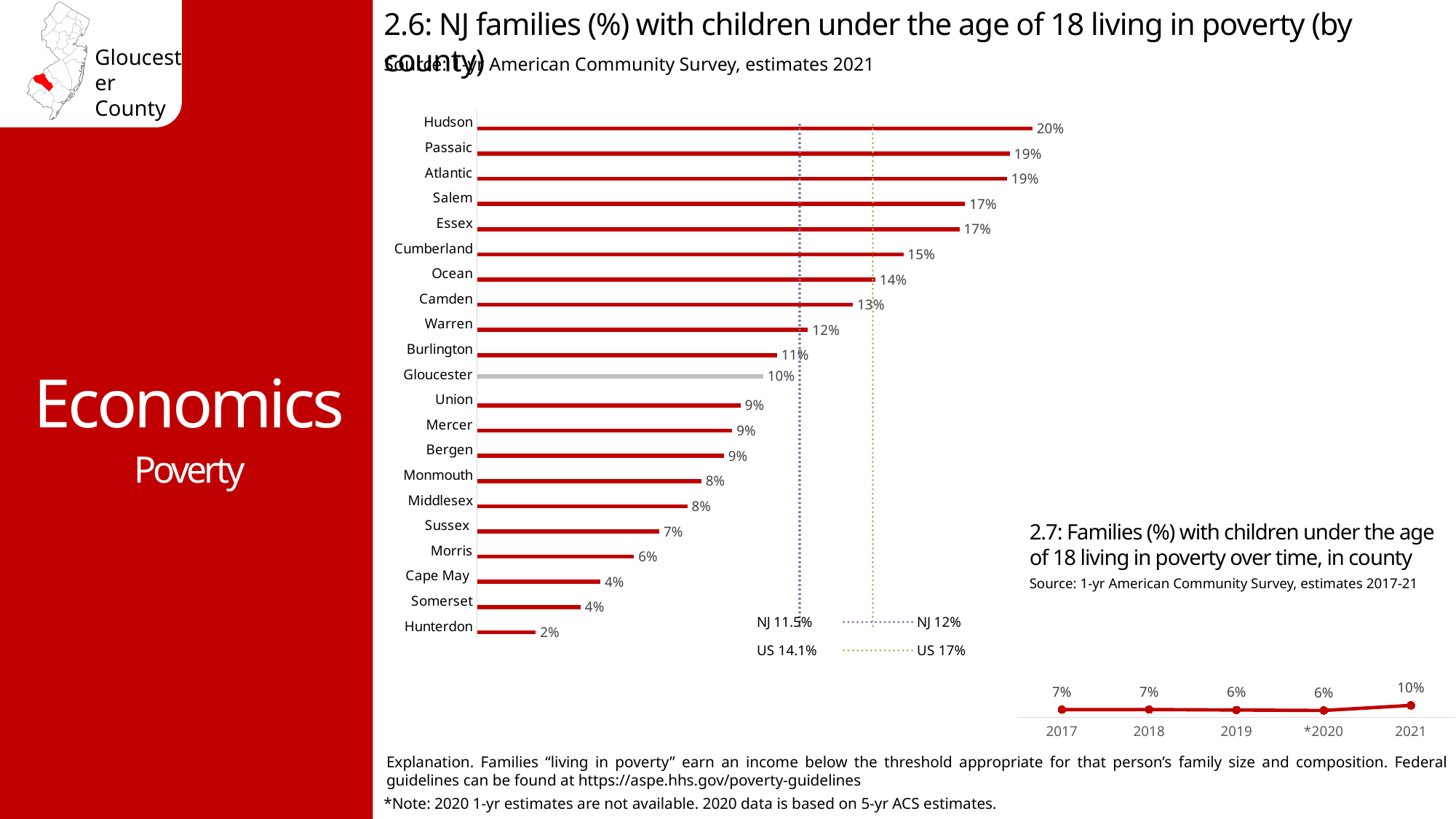
In chart 2.7 (families with children under 18 living in poverty over time, in county), what is the value for 2021? 10% What type of chart is chart 2.6? Bar chart In chart 2.6, which county has the lowest percentage of families with children living in poverty? Hunterdon In chart 2.6, how many counties are shown? 21 In chart 2.6, which county has a higher value, Camden or Burlington? Camden In chart 2.7, what is the value for 2019? 6% In chart 2.6, what is the difference between the values for Hudson and Gloucester? 10 percentage points In chart 2.6, what is the value for Cumberland? 15% In chart 2.6 (NJ families with children under 18 living in poverty by county), what is the value for Gloucester? 10% In chart 2.6, which county has the highest percentage of families with children living in poverty? Hudson In chart 2.7, how many years are plotted? 5